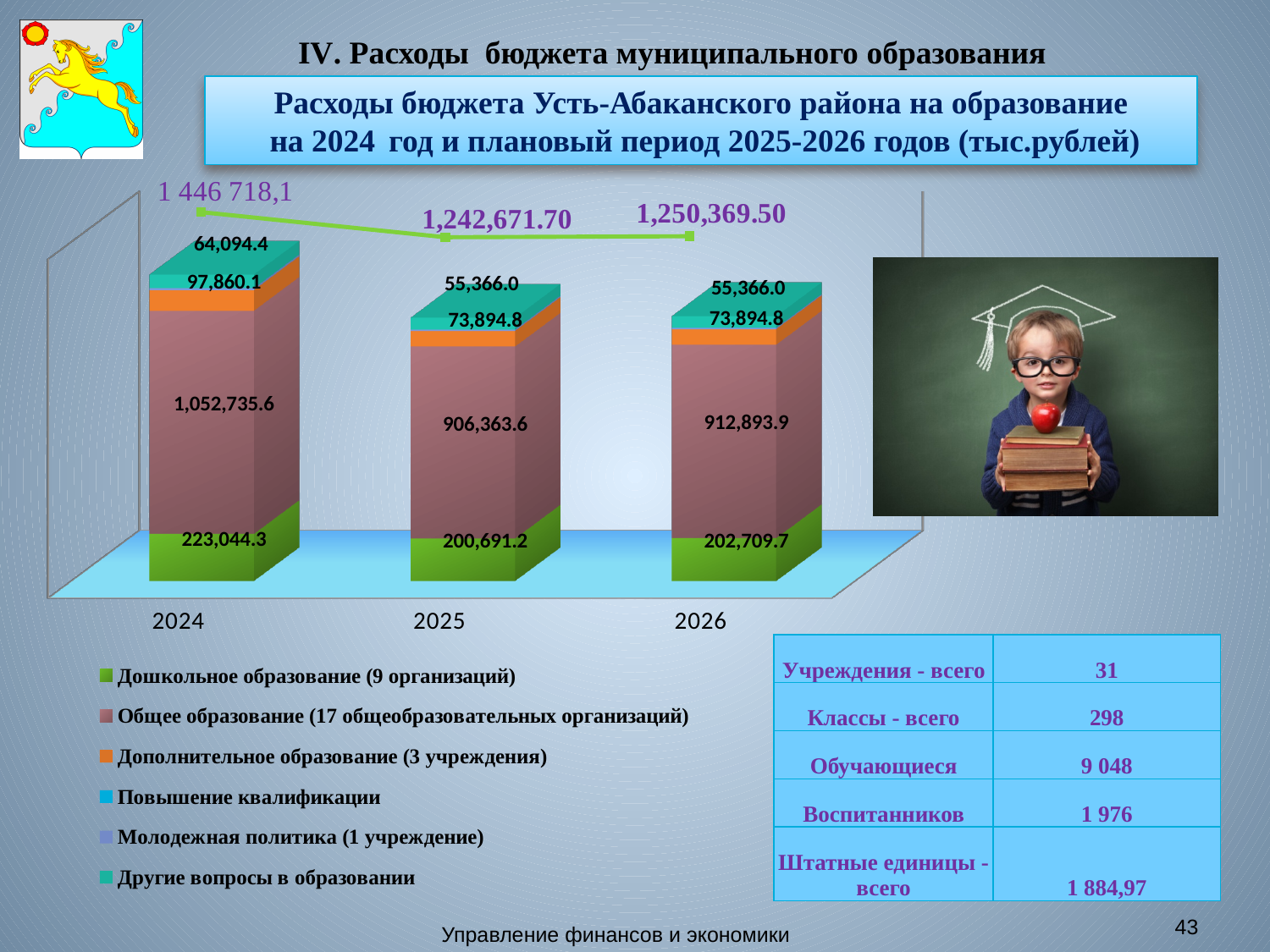
Is the value for Общее образование in 2025 larger or smaller than in 2026? smaller What is the difference between the Дошкольное образование values for 2026 and 2025? 2,018.5 What is the value for Дошкольное образование in 2024? 223,044.3 How many years (categories) are shown on the x axis of the chart? 3 What is the value for Общее образование in 2026? 912,893.9 What type of chart is shown on the slide? stacked bar chart What is the total education expenditure shown for 2026? 1,250,369.50 What is the total education expenditure shown for 2025? 1,242,671.70 How many series does the chart legend list? 6 Which year has the highest value for Общее образование? 2024 Which year has the lowest value for Дошкольное образование? 2025 What is the value for Общее образование in 2025? 906,363.6